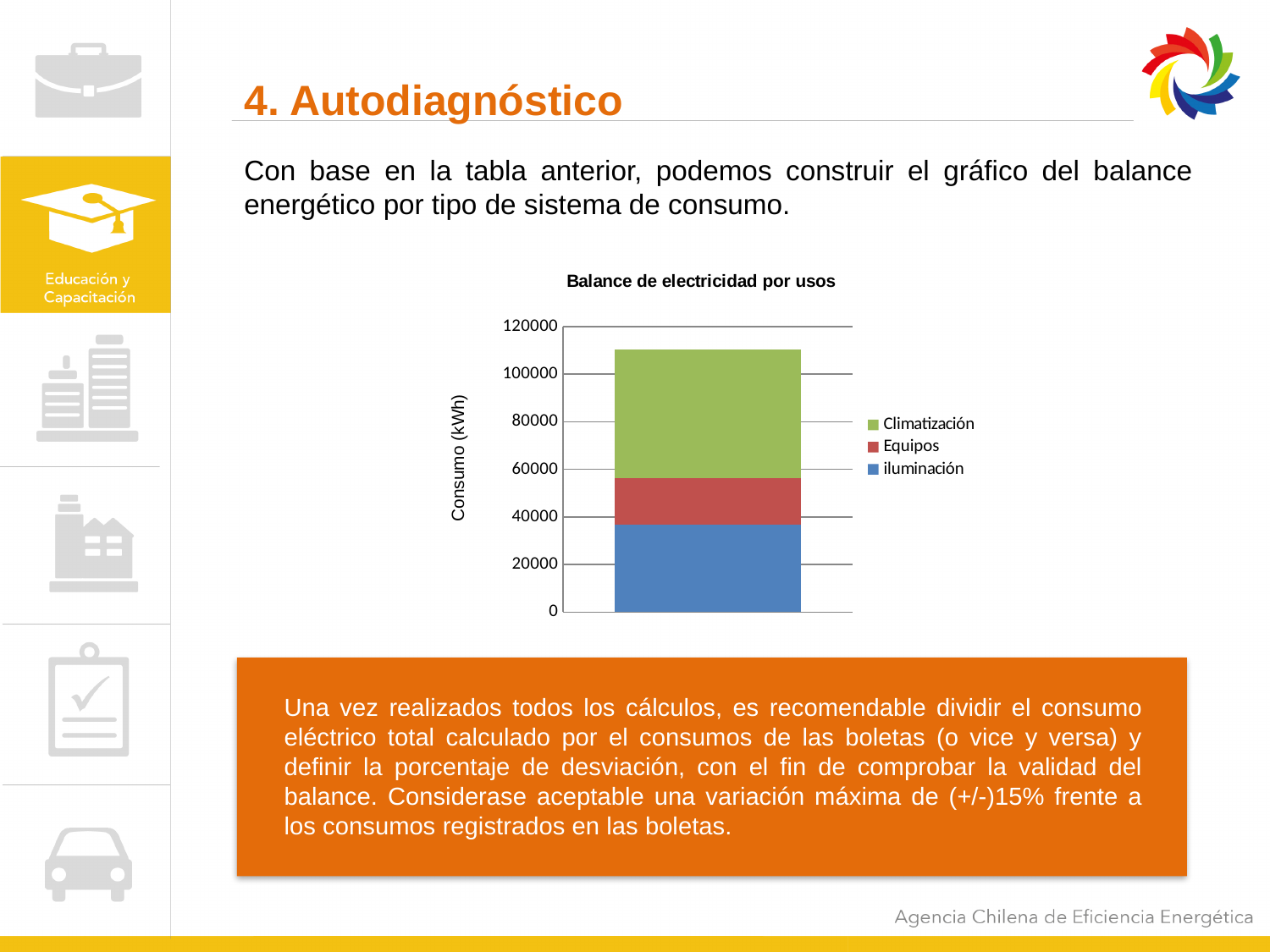
How many bars are plotted in the chart? 1 Is the value for Climatización greater or less than 40000? greater Is the value for iluminación greater or less than 40000? less What is the label of the vertical axis? Consumo (kWh) Which series accounts for the largest segment of the stacked bar? Climatización What kind of chart is shown on the slide? stacked bar chart Which series accounts for the smallest segment of the stacked bar? Equipos Which segment is larger, iluminación or Equipos? iluminación Is the total height of the stacked bar greater or less than 100000? greater How many series does the legend list? 3 Which segment is larger, Climatización or iluminación? Climatización What is the title of the chart? Balance de electricidad por usos